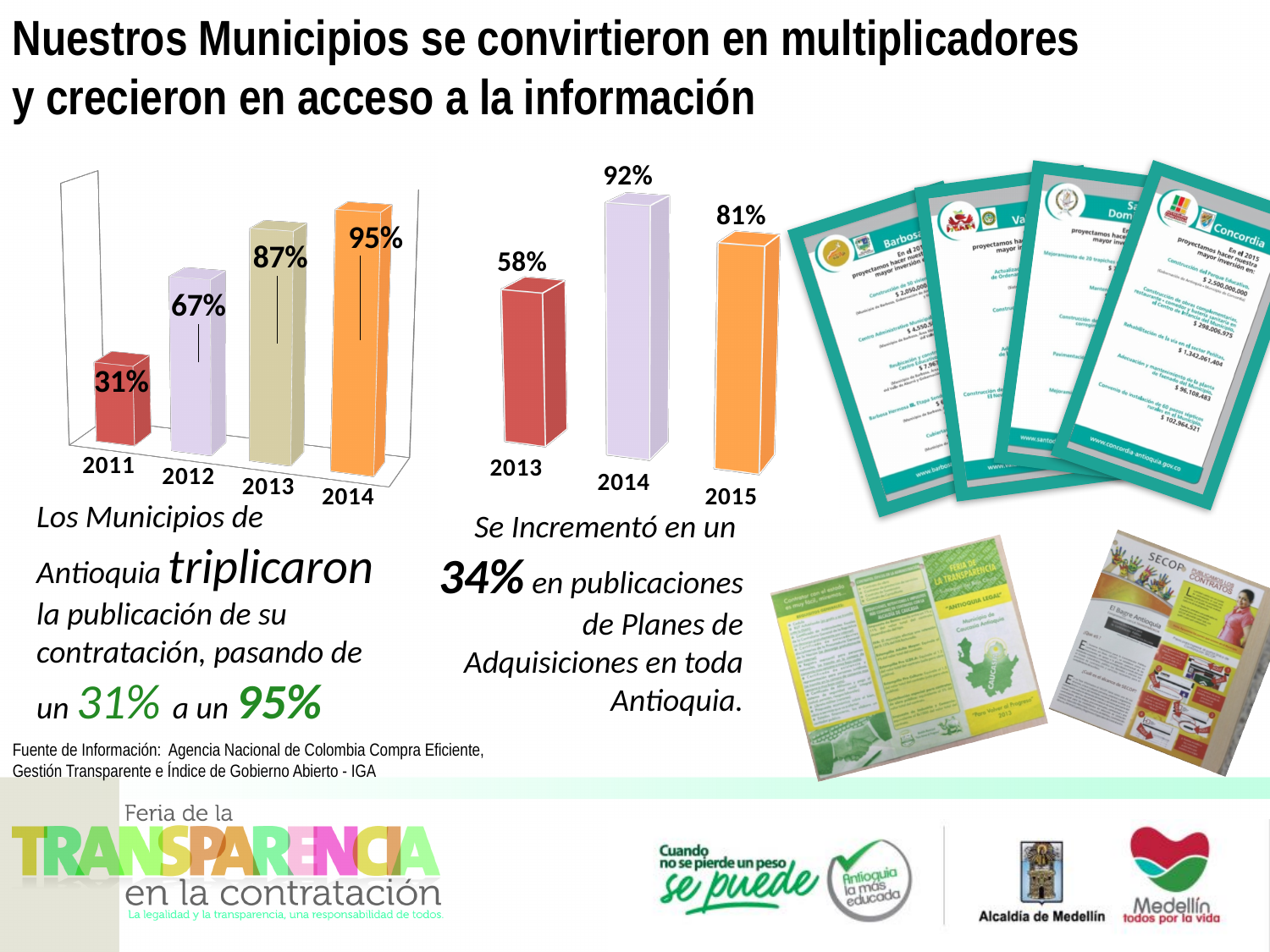
In the middle chart, what is the value for 2014? 92% In the left chart, do the values rise or fall from 2011 to 2014? rise In the left chart, what is the value for 2013? 87% What kind of chart is the middle chart? bar chart In the left chart, which year has the lowest value? 2011 In the middle chart, what is the value for 2015? 81% In the left chart, what is the difference between the values for 2014 and 2011? 64% In the middle chart, what is the difference between the values for 2014 and 2013? 34% In the middle chart, which year has the lowest value? 2013 In the left chart, which year has the highest value? 2014 How many bars does the left chart have? 4 In the left chart, what is the value for 2011? 31%